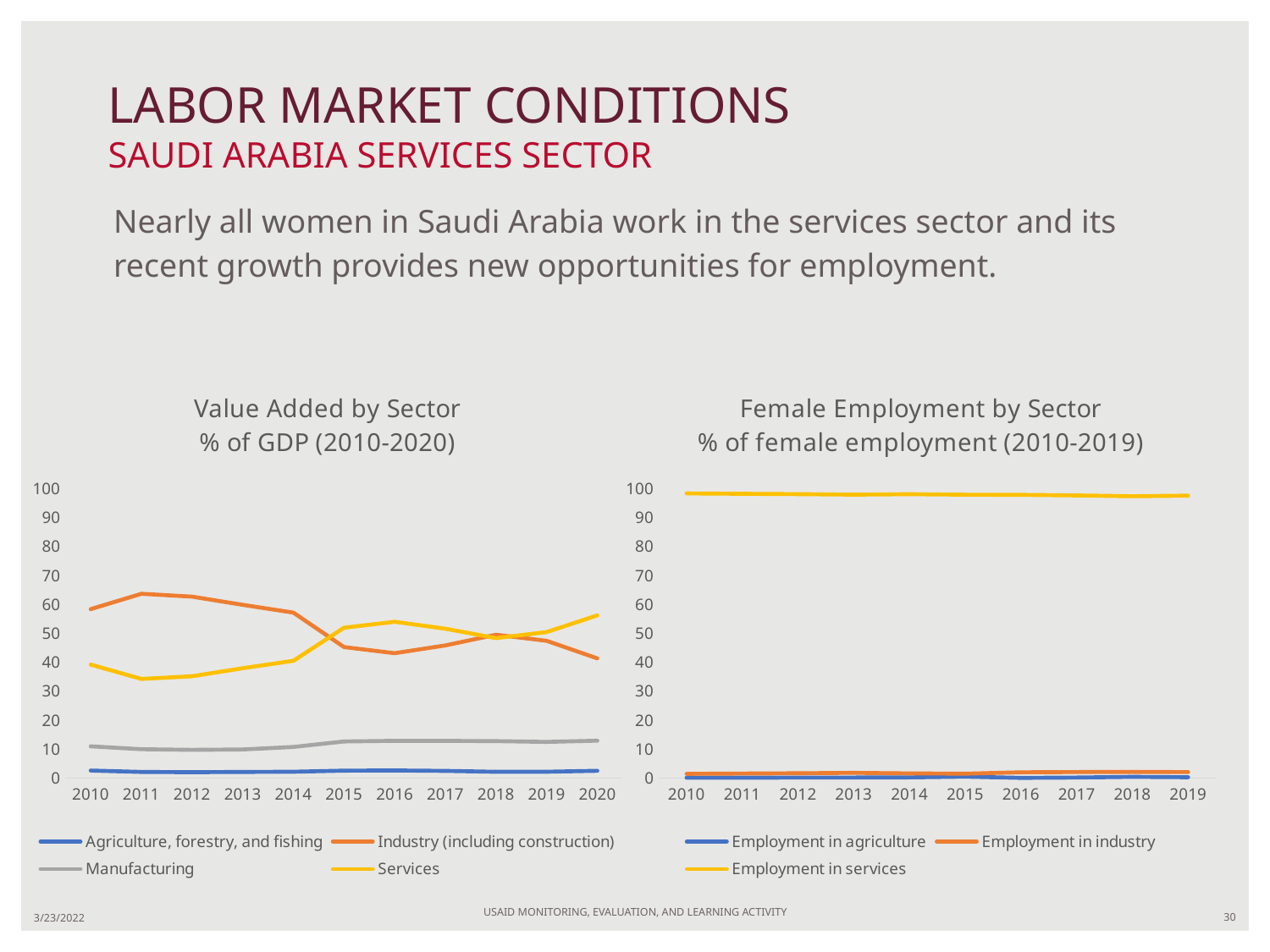
How many years are plotted on the x axis of the 'Value Added by Sector' chart? 11 In the 'Female Employment by Sector' chart, is the value for Employment in services in 2019 greater or less than 90? greater In the 'Value Added by Sector' chart, is the value for Industry (including construction) in 2011 greater or less than 60? greater How many series does the legend of the 'Female Employment by Sector' chart list? 3 What kind of chart is the 'Value Added by Sector' chart on the left? Line chart In the 'Value Added by Sector' chart, which is larger in 2020: Services or Industry (including construction)? Services In the 'Value Added by Sector' chart, does the Industry (including construction) line rise or fall from 2011 to 2020? Fall In the 'Value Added by Sector' chart, is the value for Services in 2011 greater or less than 40? less How many series does the legend of the 'Value Added by Sector' chart list? 4 In the 'Value Added by Sector' chart, which series has the lowest value across all years? Agriculture, forestry, and fishing In the 'Value Added by Sector' chart, which series has the highest value in 2010? Industry (including construction) How many years are plotted on the x axis of the 'Female Employment by Sector' chart? 10